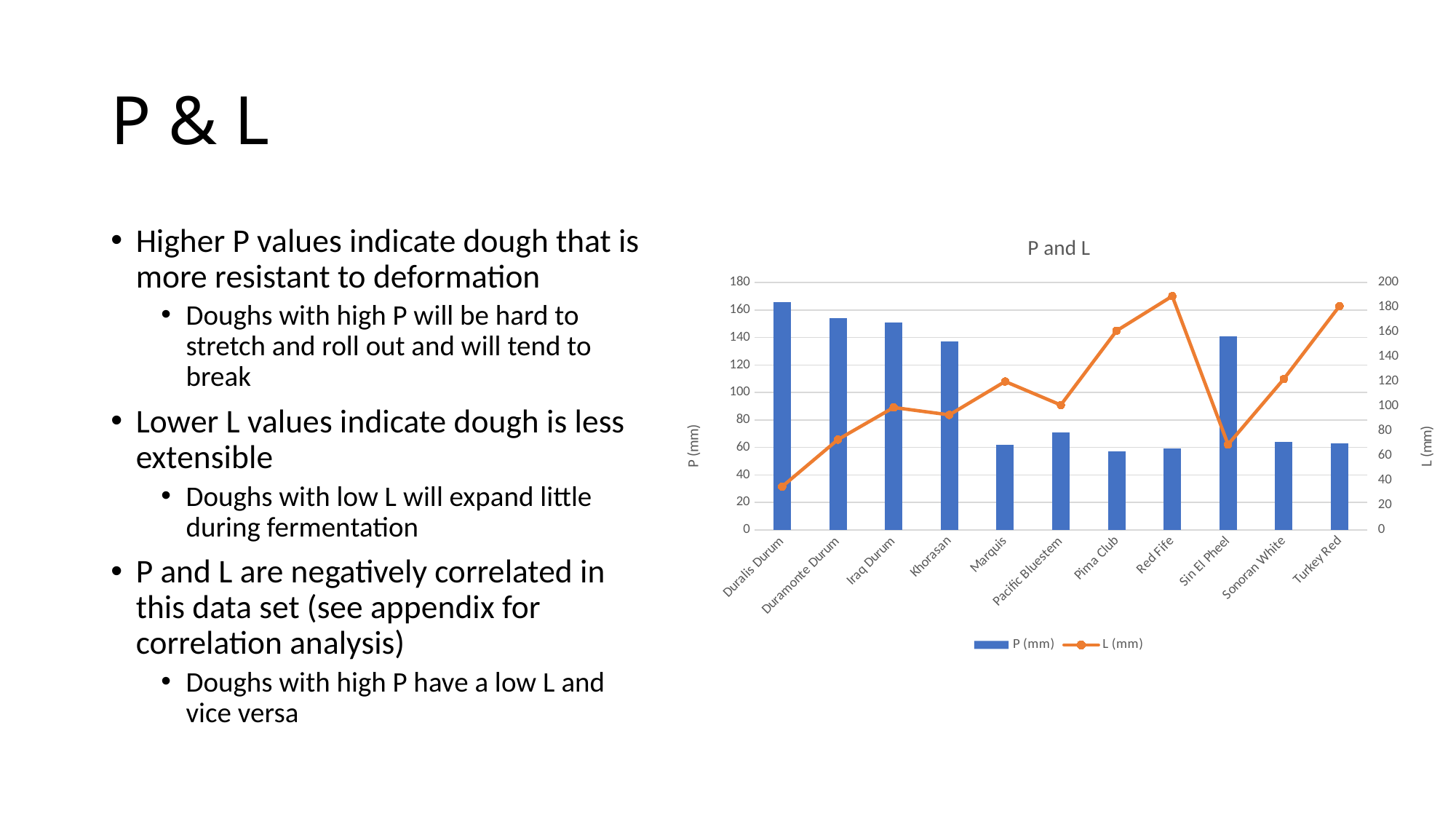
What kind of chart is shown on the slide? Combined bar and line chart What is the title of the chart? P and L Is the P (mm) value for Duralis Durum greater or less than 160? greater Which variety has the lowest L (mm) value on the line? Duralis Durum Is the P (mm) value for Khorasan greater or less than 140? less Is the P (mm) value for Marquis greater or less than 80? less Which has the larger P (mm) value, Duramonte Durum or Marquis? Duramonte Durum Does the L (mm) line rise or fall from Sin El Pheel to Turkey Red? rise Which variety has the highest P (mm) bar? Duralis Durum How many series does the chart legend list? 2 How many wheat varieties are shown on the x axis of the chart? 11